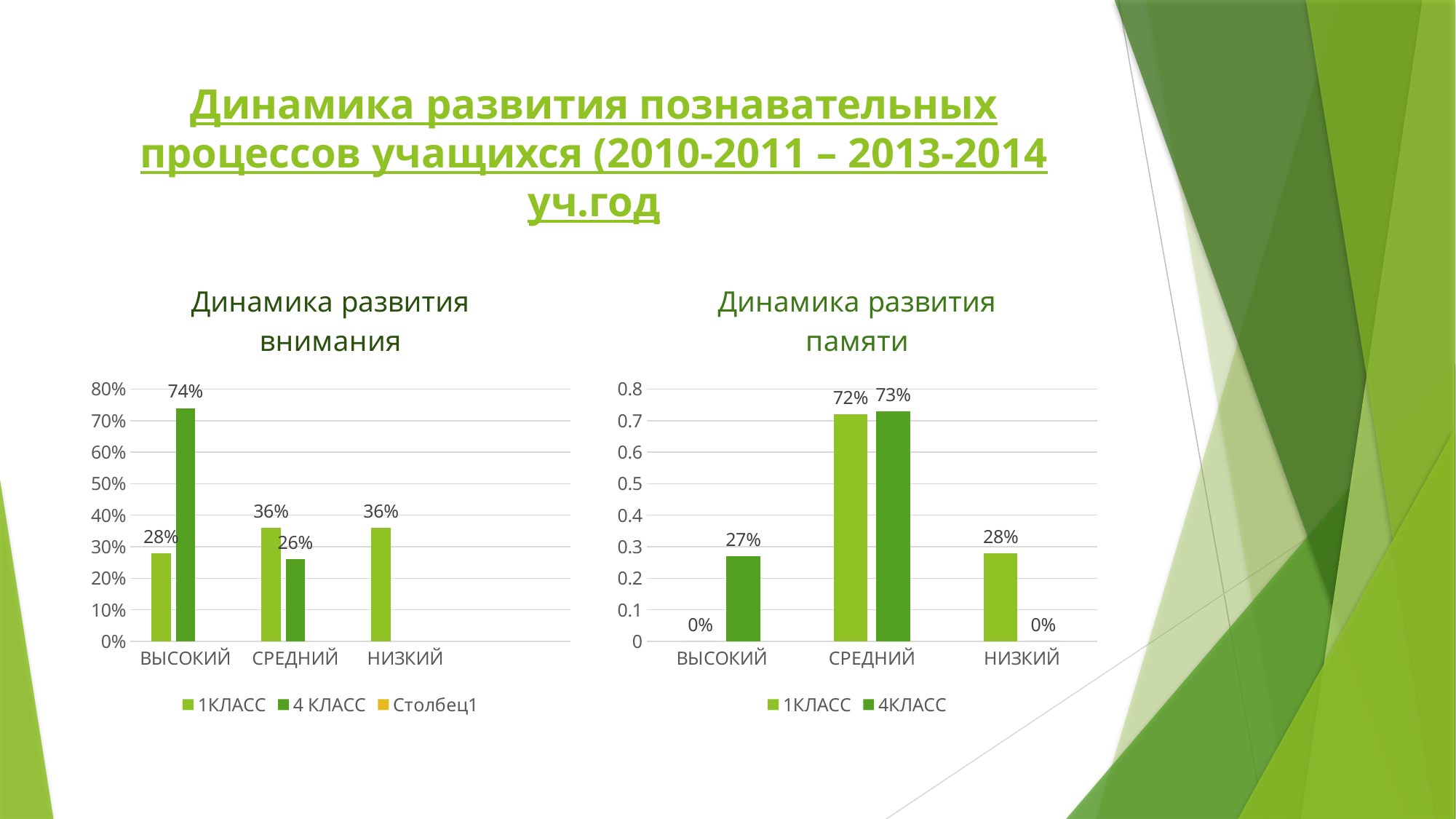
In the chart 'Динамика развития внимания', what is the difference between the 4 КЛАСС and 1КЛАСС values for ВЫСОКИЙ? 46% In the chart 'Динамика развития памяти', what is the value for 4КЛАСС in the СРЕДНИЙ category? 73% In the chart 'Динамика развития памяти', what is the value for 1КЛАСС in the ВЫСОКИЙ category? 0% In the chart 'Динамика развития внимания', which category has the highest value for 4 КЛАСС? ВЫСОКИЙ In the chart 'Динамика развития внимания', what is the value for 1КЛАСС in the СРЕДНИЙ category? 36% In the chart 'Динамика развития внимания', what is the difference between the 1КЛАСС and 4 КЛАСС values for СРЕДНИЙ? 10% In the chart 'Динамика развития памяти', which is larger: the 1КЛАСС value for НИЗКИЙ or the 4КЛАСС value for ВЫСОКИЙ? 1КЛАСС value for НИЗКИЙ What type of chart is 'Динамика развития памяти'? Bar chart In the chart 'Динамика развития внимания', what is the value for 4 КЛАСС in the ВЫСОКИЙ category? 74% In the chart 'Динамика развития памяти', how many categories are shown on the x axis? 3 In the chart 'Динамика развития внимания', how many series does the legend list? 3 In the chart 'Динамика развития памяти', which category has the lowest value for 4КЛАСС? НИЗКИЙ